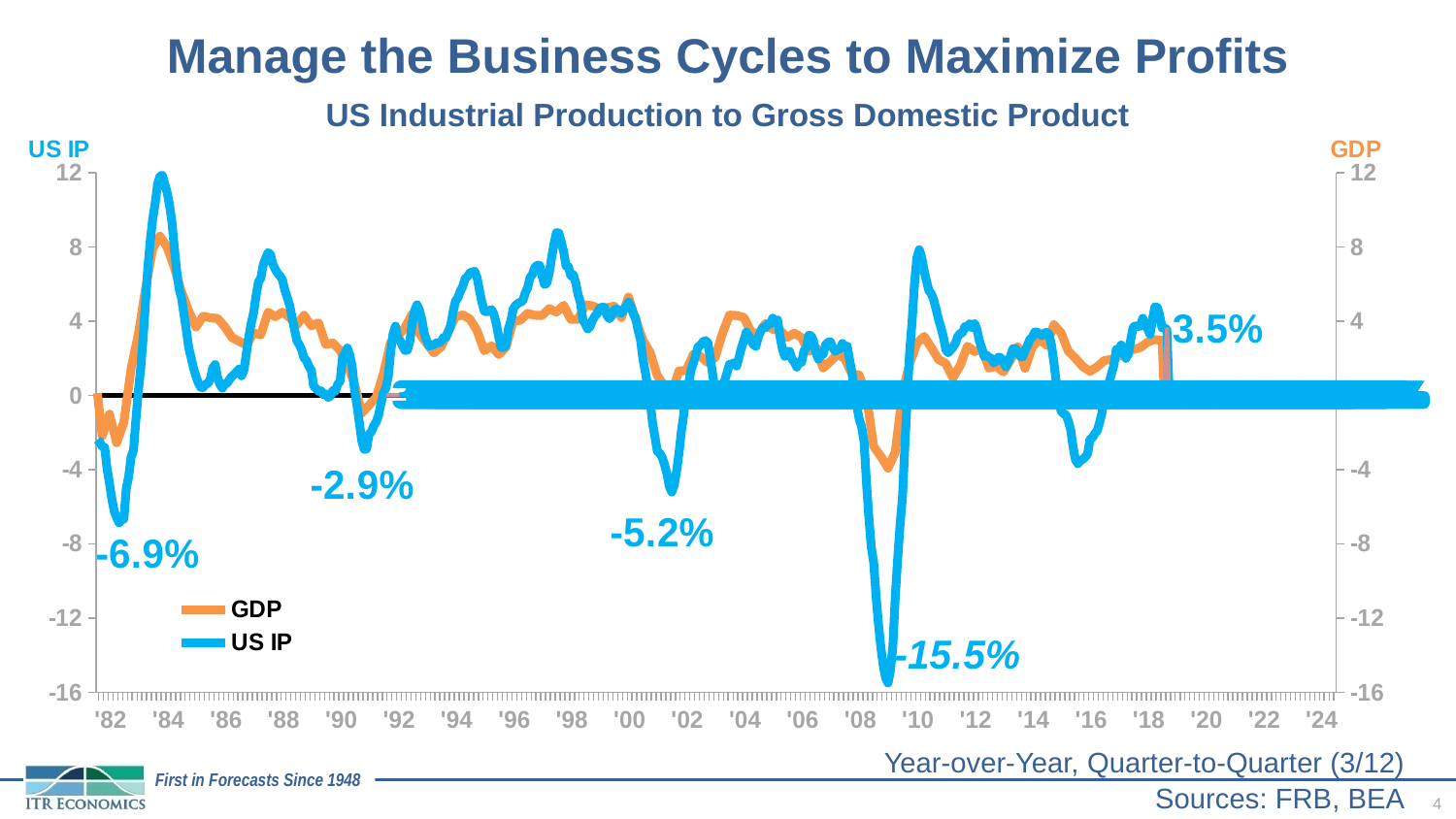
Around 2009, which series fell lower, GDP or US IP? US IP What is the difference between the US IP low of -6.9% and the low of -15.5%? 8.6 percentage points What is the labelled low value of US IP around 1991? -2.9% What is the labelled low value of US IP around 2001? -5.2% What are the two series named in the legend? GDP and US IP How many series does the legend list? 2 What is the labelled low value of US IP around 1982? -6.9% Which of the labelled US IP values is the lowest? -15.5% What is the most recent labelled value of US IP, shown near 2018? 3.5% What is the labelled low value of US IP around 2009? -15.5% What type of chart is shown on the slide? line chart What colour is the US IP line? blue